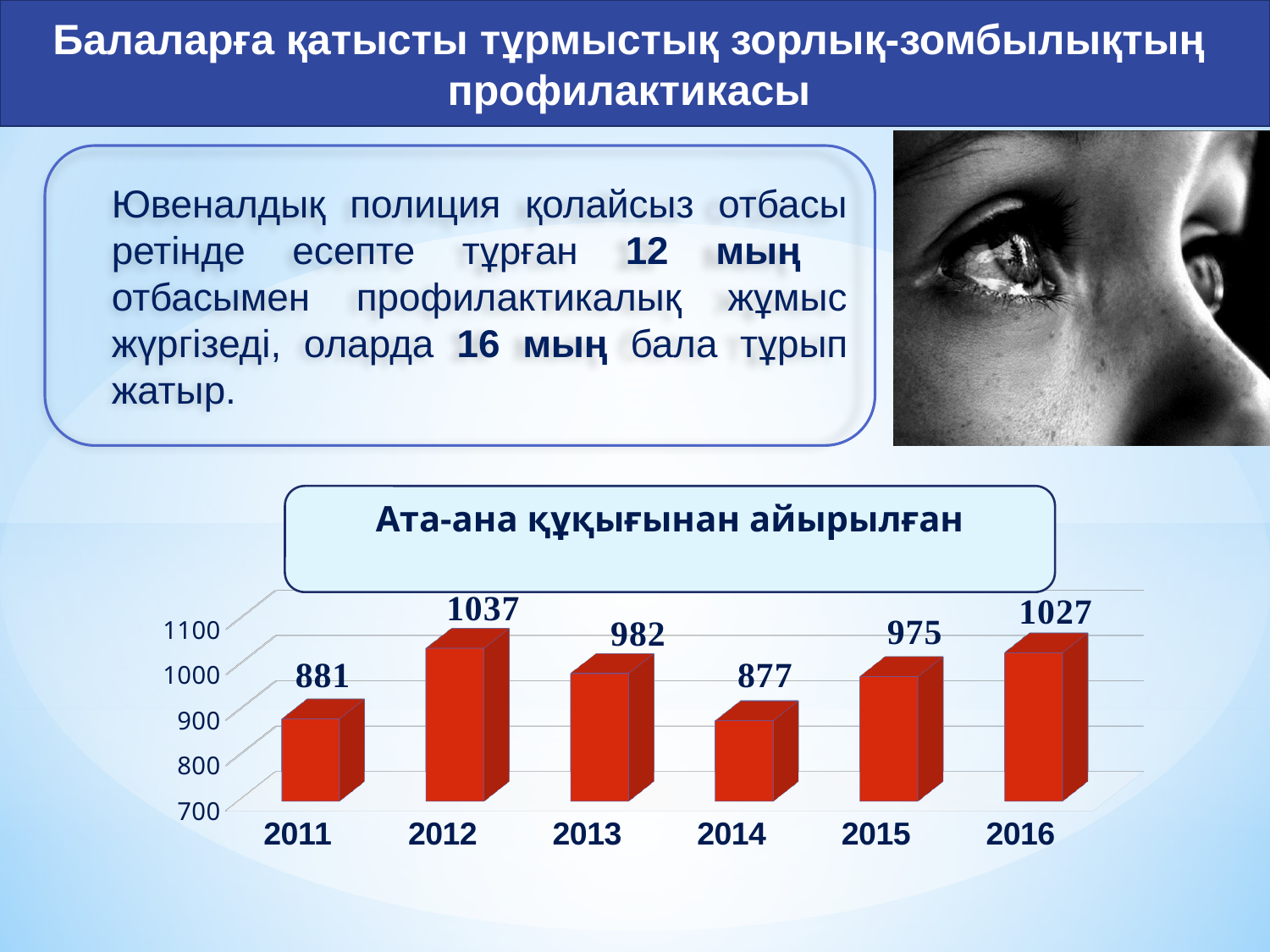
What kind of chart is shown on the slide? bar chart Which year has the highest value? 2012 What is the value for 2016? 1027 Which is larger, the value for 2013 or the value for 2015? 2013 What is the value for 2011? 881 How many years are shown on the x axis? 6 Which year has the lowest value? 2014 What is the difference between the values for 2012 and 2011? 156 What is the title of the chart? Ата-ана құқығынан айырылған Is the value for 2012 greater or less than 1000? greater What is the value for 2014? 877 What is the difference between the values for 2016 and 2015? 52